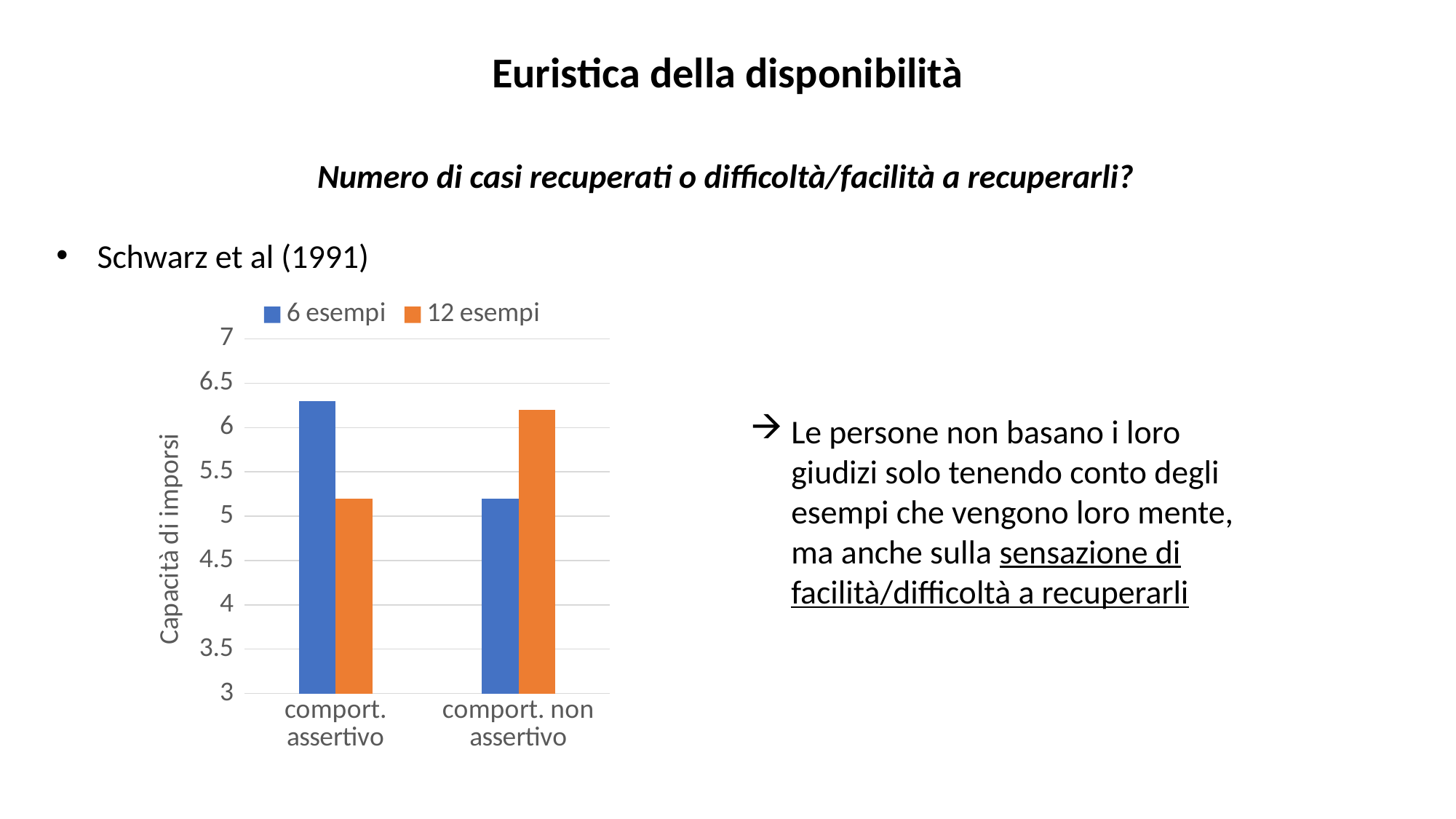
What is the label of the chart's vertical axis? Capacità di imporsi Is the value for 6 esempi in the comport. non assertivo category greater or less than 5.5? less What kind of chart is shown on the slide? bar chart For comport. assertivo, which series has the larger value, 6 esempi or 12 esempi? 6 esempi Is the value for 6 esempi in the comport. assertivo category greater or less than 6? greater Is the value for 12 esempi in the comport. assertivo category greater or less than 5.5? less How many series does the chart's legend list? 2 How many categories are shown on the x axis of the chart? 2 Which category has the lowest value for the 12 esempi series? comport. assertivo Which category has the highest value for the 6 esempi series? comport. assertivo For comport. non assertivo, which series has the larger value, 6 esempi or 12 esempi? 12 esempi